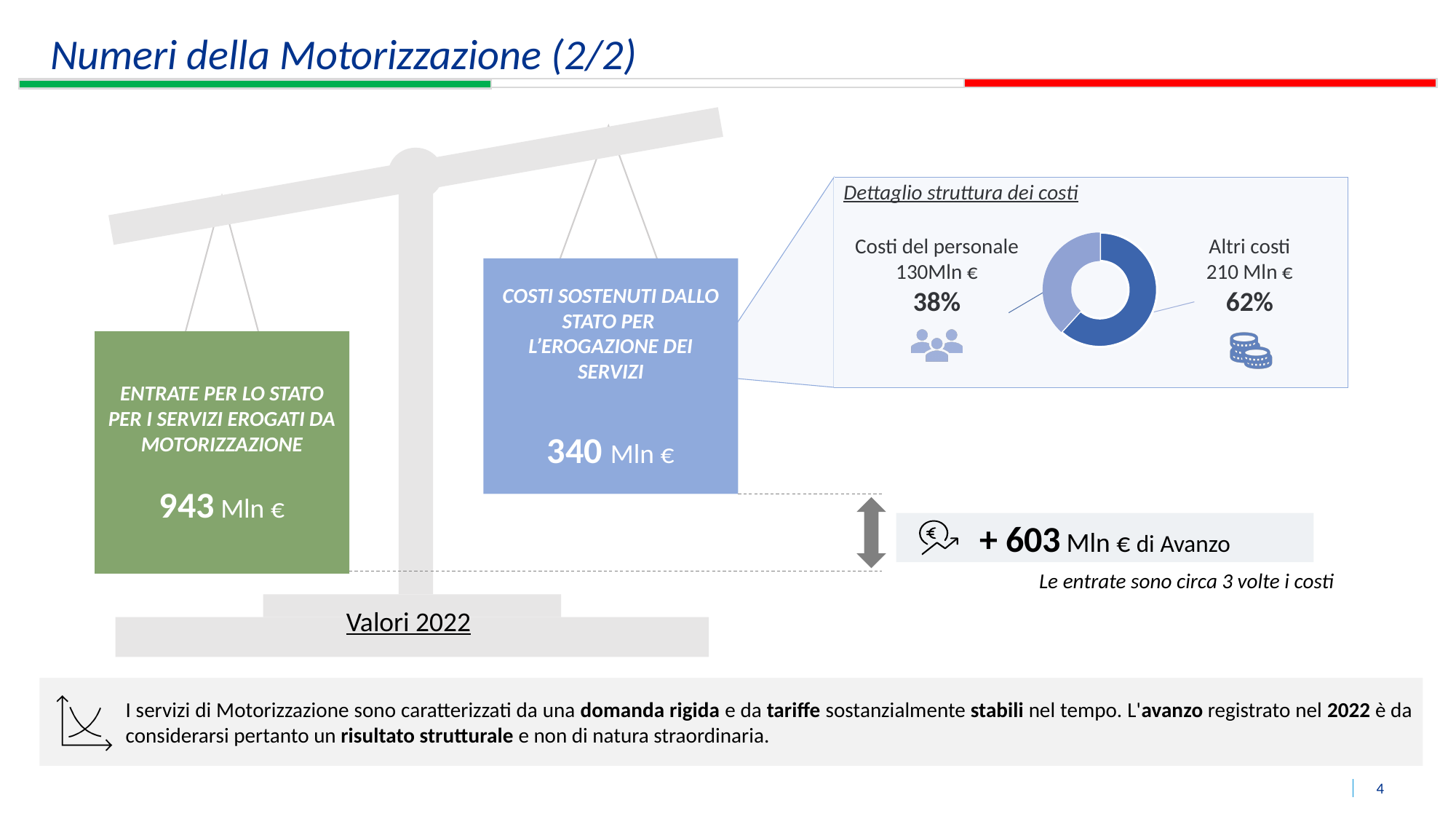
In the 'Dettaglio struttura dei costi' chart, which category has the largest slice? Altri costi In the 'Dettaglio struttura dei costi' chart, what is the difference between Altri costi and Costi del personale? 80 Mln € In the 'Dettaglio struttura dei costi' chart, what share of the total do Altri costi represent? 62% In the 'Dettaglio struttura dei costi' chart, which category has the smallest slice? Costi del personale In the 'Dettaglio struttura dei costi' chart, what is the value for Altri costi? 210 Mln € What kind of chart is shown in the 'Dettaglio struttura dei costi' box? donut (pie) chart In the 'Dettaglio struttura dei costi' chart, which is larger: Costi del personale or Altri costi? Altri costi What is the title of the box containing the donut chart? Dettaglio struttura dei costi What is the total of the two slices in the 'Dettaglio struttura dei costi' chart? 340 Mln € In the 'Dettaglio struttura dei costi' chart, what share of the total do Costi del personale represent? 38% In the 'Dettaglio struttura dei costi' chart, what is the value for Costi del personale? 130Mln € How many slices does the 'Dettaglio struttura dei costi' chart have? 2